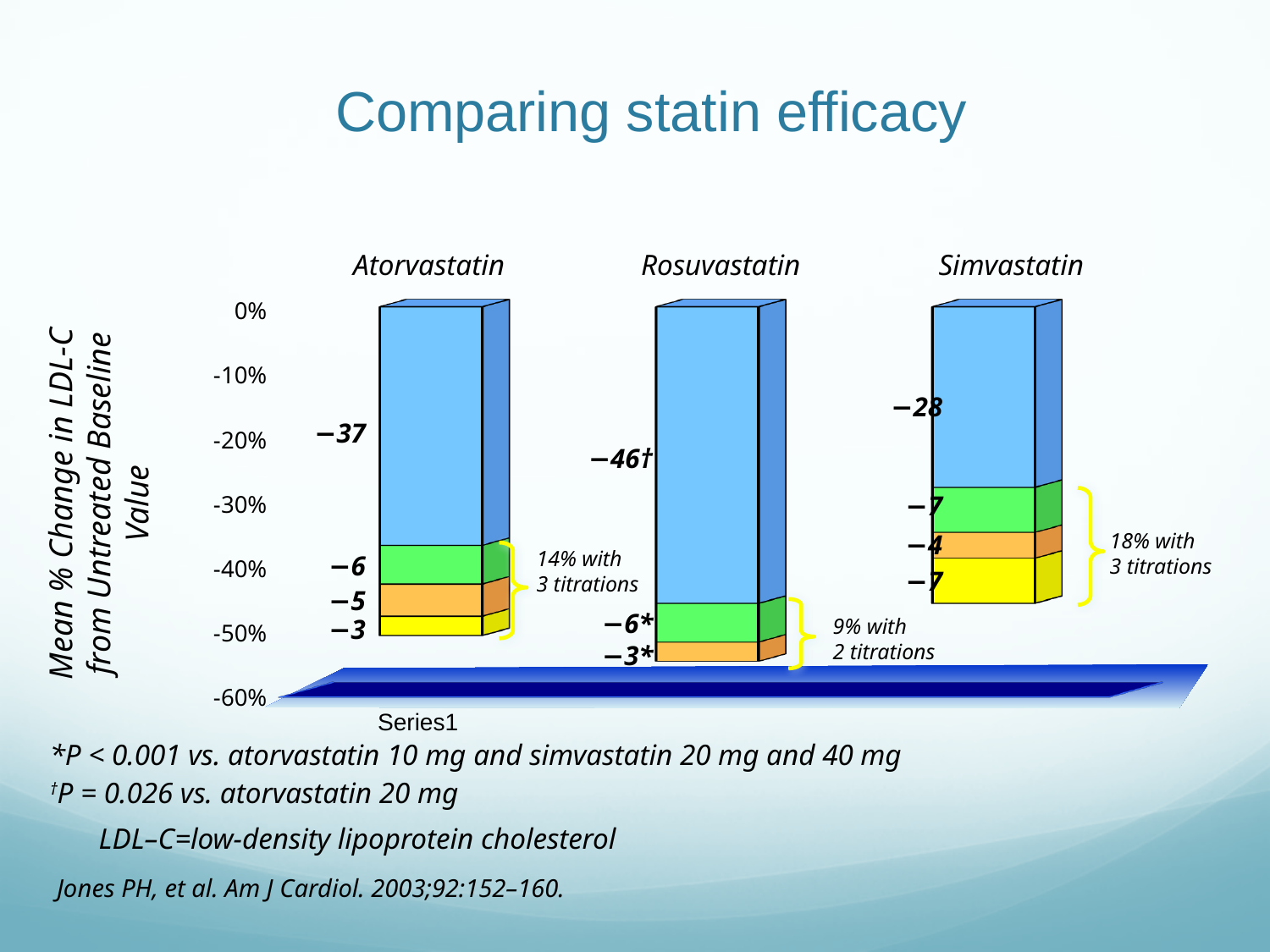
What is the difference between the blue segment values of Rosuvastatin (−46) and Atorvastatin (−37)? 9 What is the value of the orange segment of the Atorvastatin bar? −5 What type of chart is shown on the slide? Stacked bar chart Which statin has the smallest blue (first) segment? Simvastatin What is the value of the top (blue) segment of the Simvastatin bar? −28 What is the total of all segments in the Atorvastatin bar? −51 What is the title of the chart's vertical axis? Mean % Change in LDL-C from Untreated Baseline Value What is the value of the bottom (yellow) segment of the Simvastatin bar? −7 How many statins (bars) are shown in the chart? 3 What is the value of the top (blue) segment of the Rosuvastatin bar? −46 Which statin has the largest blue (first) segment? Rosuvastatin What is the value of the top (blue) segment of the Atorvastatin bar? −37